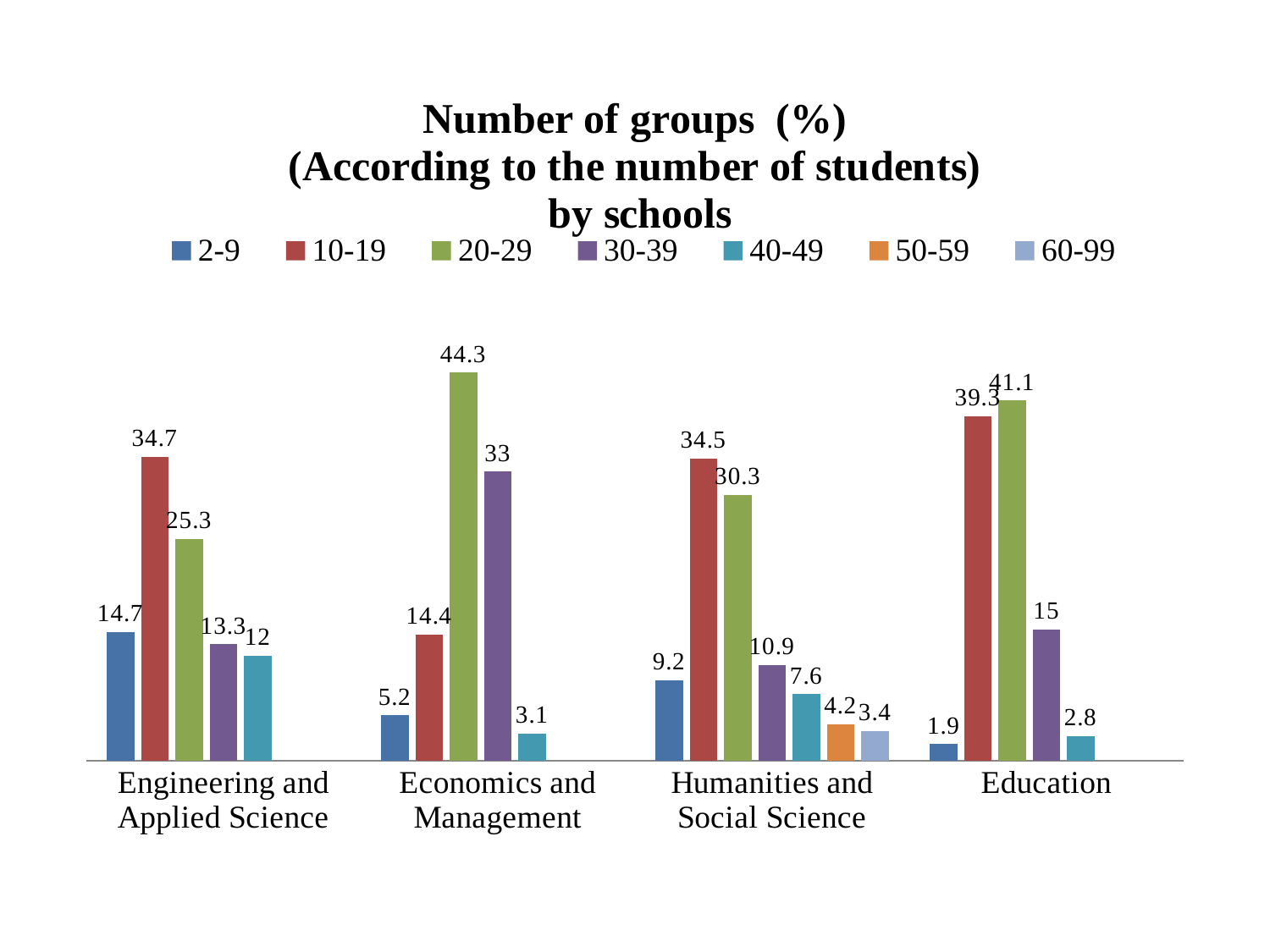
What kind of chart is shown on the slide? bar chart What is the difference between the 10-19 values for Engineering and Applied Science and Economics and Management? 20.3 Which school is the only one with bars for the 50-59 and 60-99 series? Humanities and Social Science What is the value for the 2-9 series for Education? 1.9 Which school has the highest value for the 10-19 series? Education How many series does the legend list? 7 What is the value for the 20-29 series for Economics and Management? 44.3 What is the value for the 40-49 series for Engineering and Applied Science? 12 How many schools (categories) are shown on the x axis? 4 Which school has the lowest value for the 2-9 series? Education What is the difference between the 20-29 and 30-39 values for Economics and Management? 11.3 Which is larger for Humanities and Social Science: the 10-19 value or the 20-29 value? 10-19